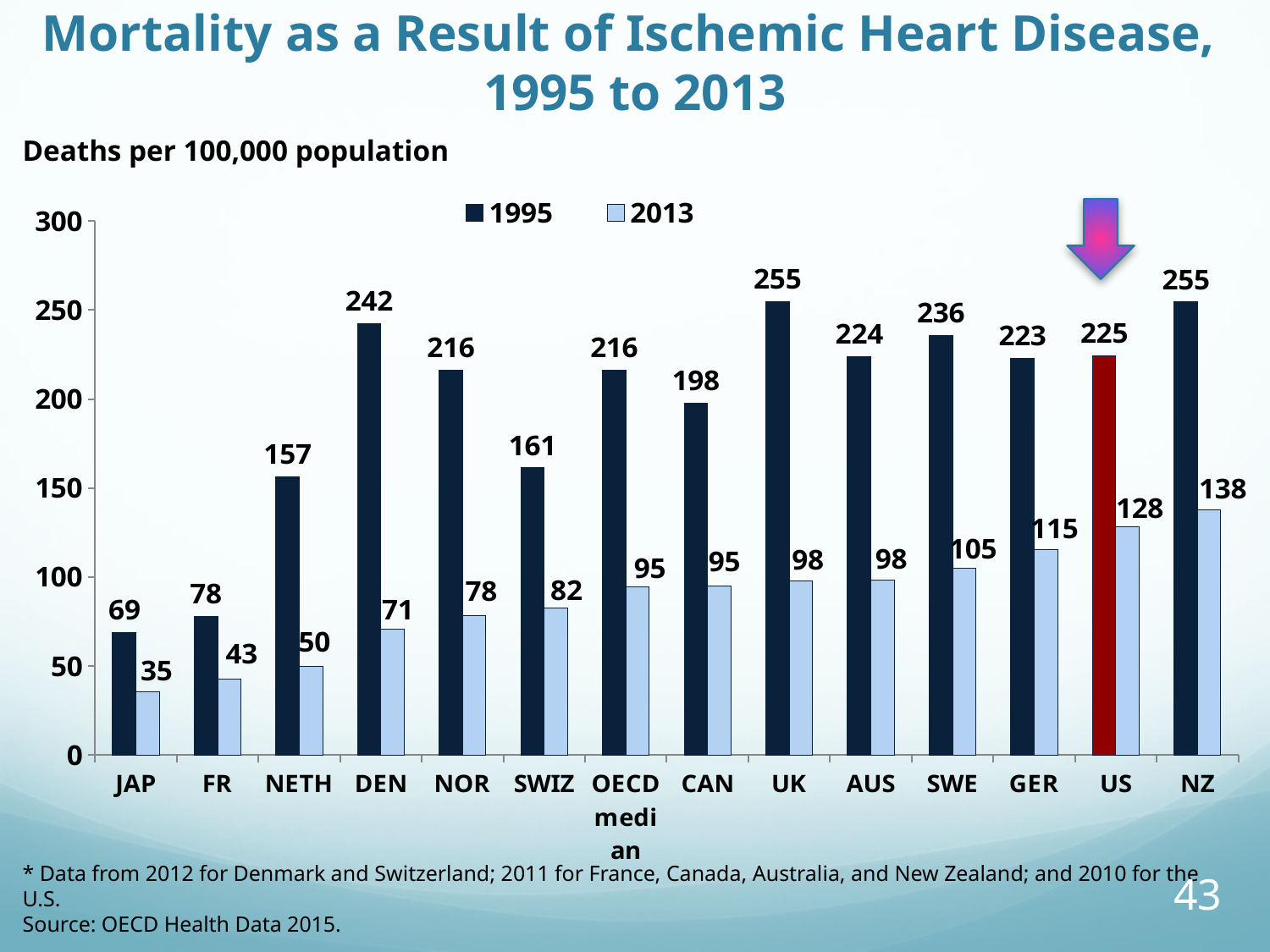
What was the 2013 value for the OECD median? 95 How many series does the legend list? 2 How many countries or groups are shown on the x axis? 14 What is the difference between the 2013 values for the US and the UK? 30 Which country had the lowest 1995 value? JAP Which country had the highest 2013 value? NZ Which is larger, the 2013 value for Germany (GER) or the 2013 value for Sweden (SWE)? GER What kind of chart is shown on the slide? bar chart What was the 1995 value for the US? 225 What was the 2013 value for Japan (JAP)? 35 Which year does the dark navy series in the legend represent? 1995 What is the difference between the 1995 and 2013 values for Denmark (DEN)? 171